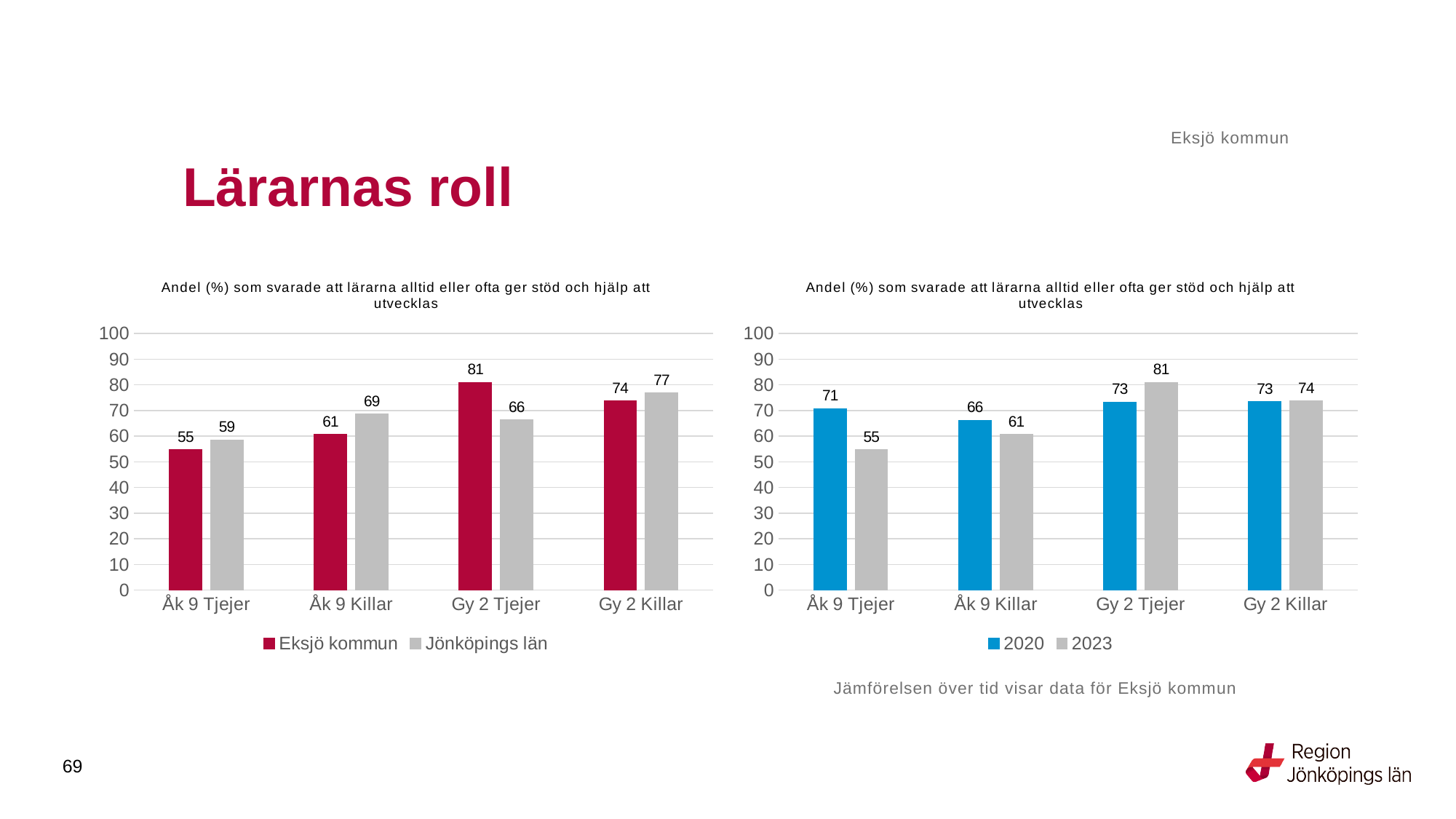
How many series does the legend of the right chart list? 2 In the right chart, what is the difference between the 2020 and 2023 values for Åk 9 Tjejer? 16 In the left chart, what is the value for Jönköpings län for Åk 9 Killar? 69 What kind of chart is the left chart? Bar chart In the left chart, what is the value for Eksjö kommun for Gy 2 Tjejer? 81 In the left chart, which category has the lowest value for Eksjö kommun? Åk 9 Tjejer In the right chart, which is larger for Gy 2 Tjejer: 2020 or 2023? 2023 In the left chart, what is the difference between the Eksjö kommun and Jönköpings län values for Gy 2 Tjejer? 15 In the right chart, which category has the highest 2023 value? Gy 2 Tjejer In the left chart, which is larger for Åk 9 Killar: Eksjö kommun or Jönköpings län? Jönköpings län In the right chart, what is the 2020 value for Gy 2 Killar? 73 In the right chart, what is the 2023 value for Åk 9 Tjejer? 55